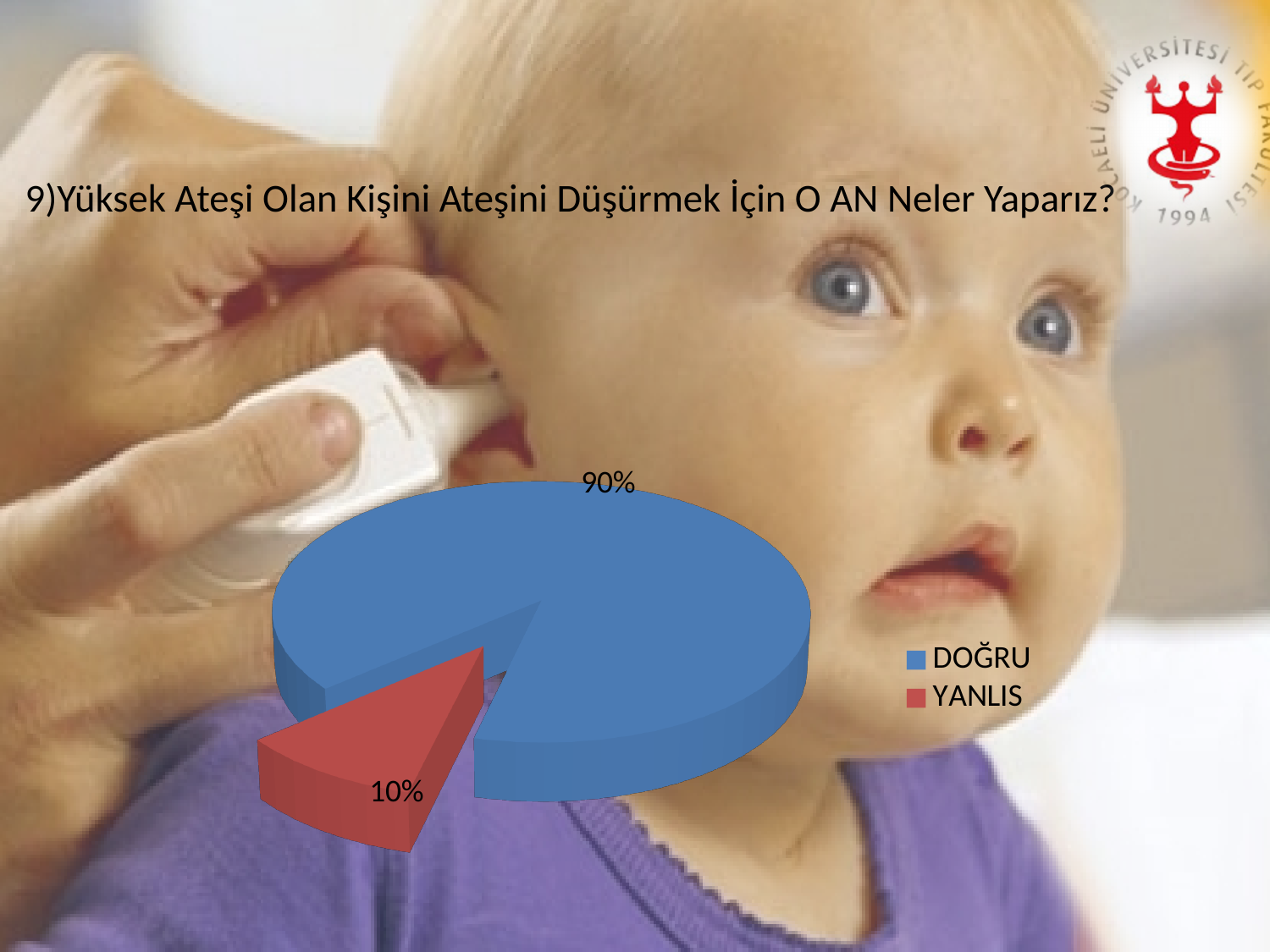
What is the difference between the DOĞRU and YANLIS shares? 80% What share of the pie does YANLIS take? 10% How many entries does the legend list? 2 Which is larger, the share for DOĞRU or the share for YANLIS? DOĞRU What kind of chart is shown on the slide? pie chart Which category has the smallest share of the pie? YANLIS What is the value for DOĞRU? 90% What is the value for YANLIS? 10% How many categories does the pie chart have? 2 What colour is the DOĞRU slice? blue Which category has the largest share of the pie? DOĞRU What colour is the YANLIS slice? red